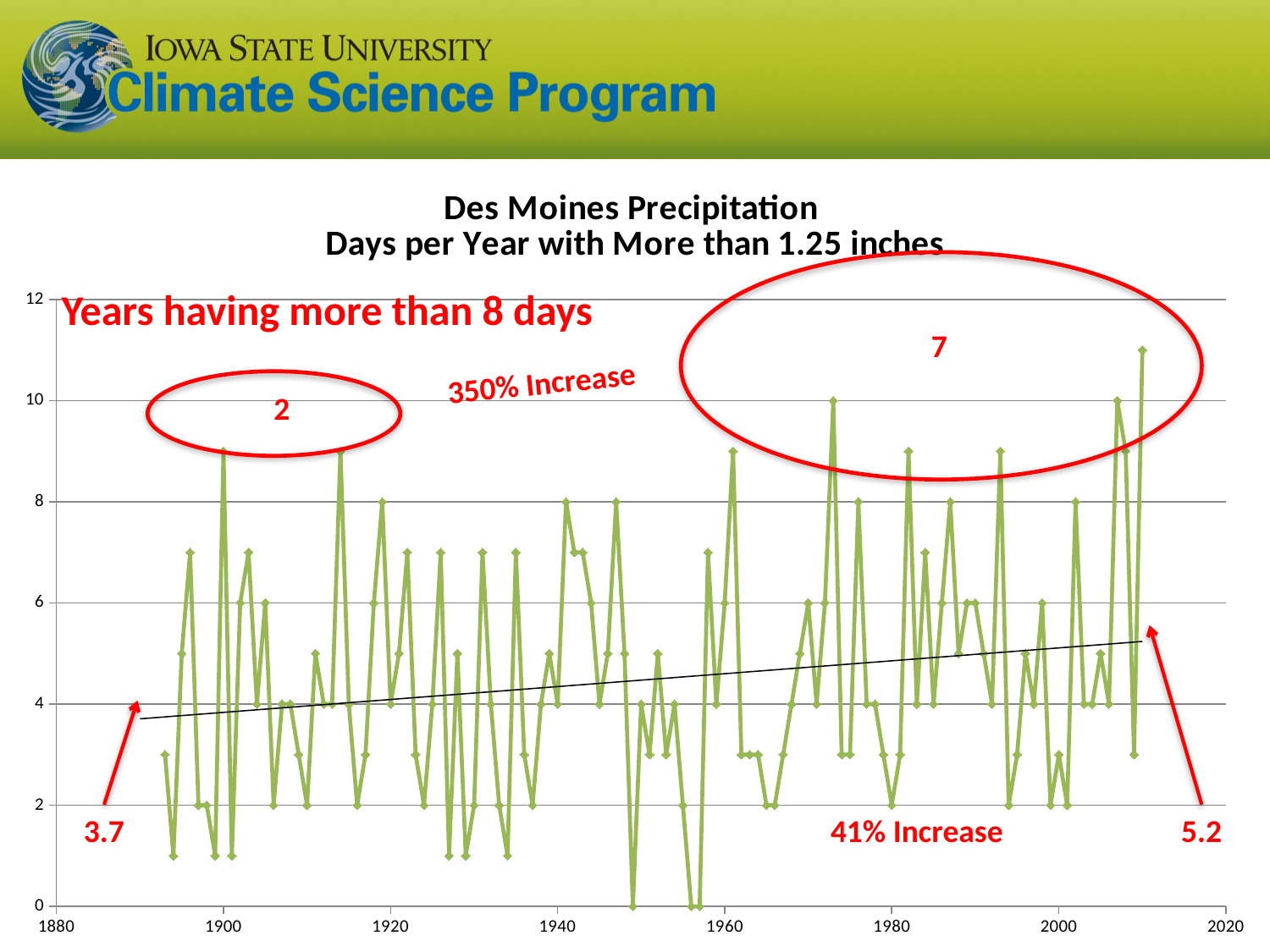
What value does the trend line start at on the left (around 1890)? 3.7 How many years having more than 8 days are counted in the early circled period (around 1895-1920)? 2 What value does the trend line end at on the right (around 2012)? 5.2 What is the title of the chart? Des Moines Precipitation Days per Year with More than 1.25 inches Is the highest plotted value (around 2010) greater or less than 10? greater What percentage increase is annotated for the number of years having more than 8 days? 350% Increase Is the value plotted around 1957 greater or less than 2? less Does the trend line rise or fall from 1890 to 2012? rises By how much does the trend line rise from its start value (3.7) to its end value (5.2)? 1.5 How many years having more than 8 days are counted in the later circled period (around 1960-2012)? 7 What percentage increase is annotated for the trend line? 41% Increase What kind of chart is shown on the slide? line chart